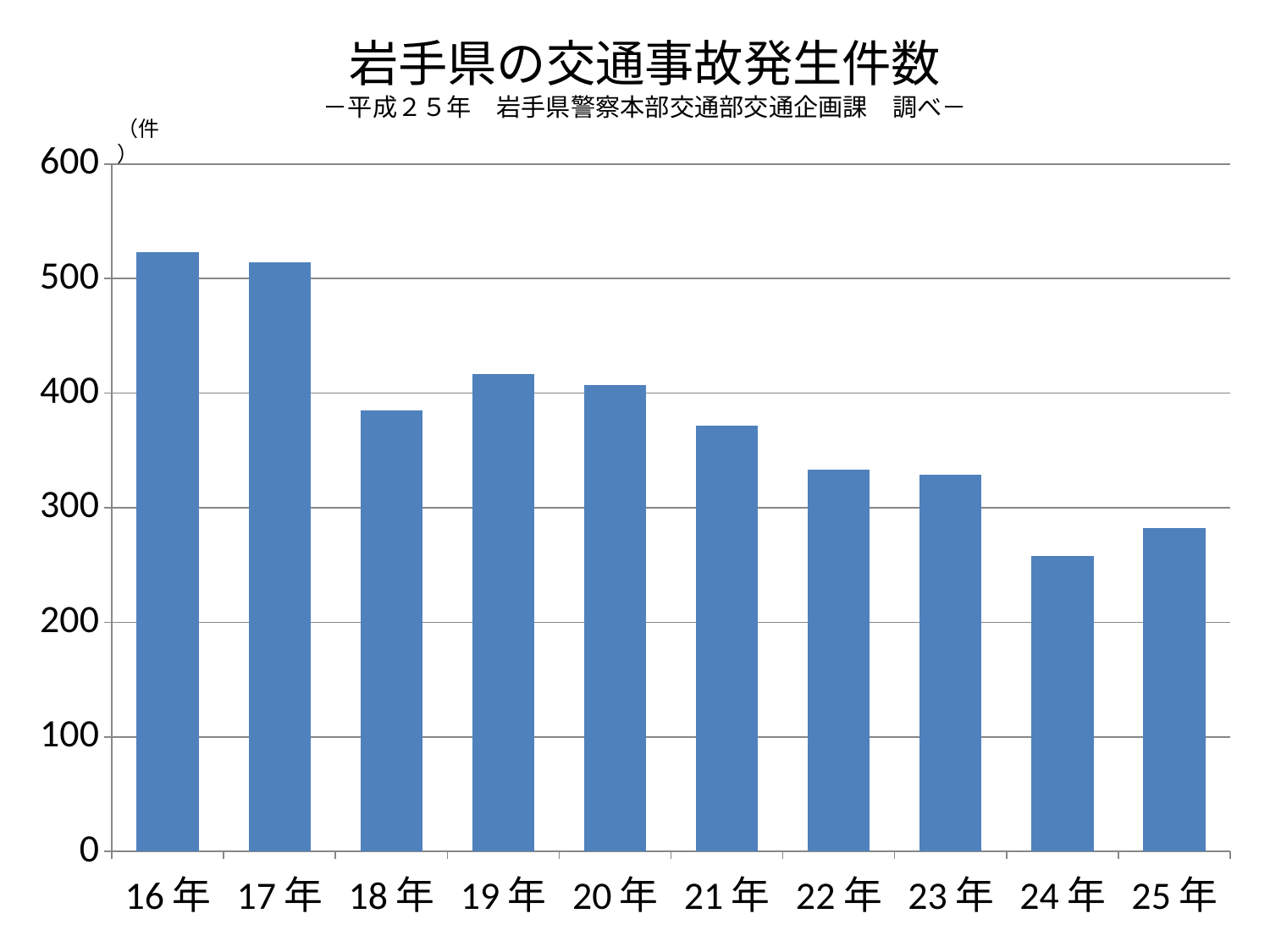
Which is larger, the value for 18年 or the value for 19年? 19年 Which year has the lowest number of traffic accidents? 24年 Is the value for 18年 greater or less than 400? less Which is larger, the value for 24年 or the value for 25年? 25年 What is the title of the chart? 岩手県の交通事故発生件数 Is the value for 24年 greater or less than 300? less How many years (bars) are plotted on the chart? 10 What kind of chart is shown on the slide? bar chart Is the value for 19年 greater or less than 400? greater Do the values generally rise or fall from 16年 to 25年? fall